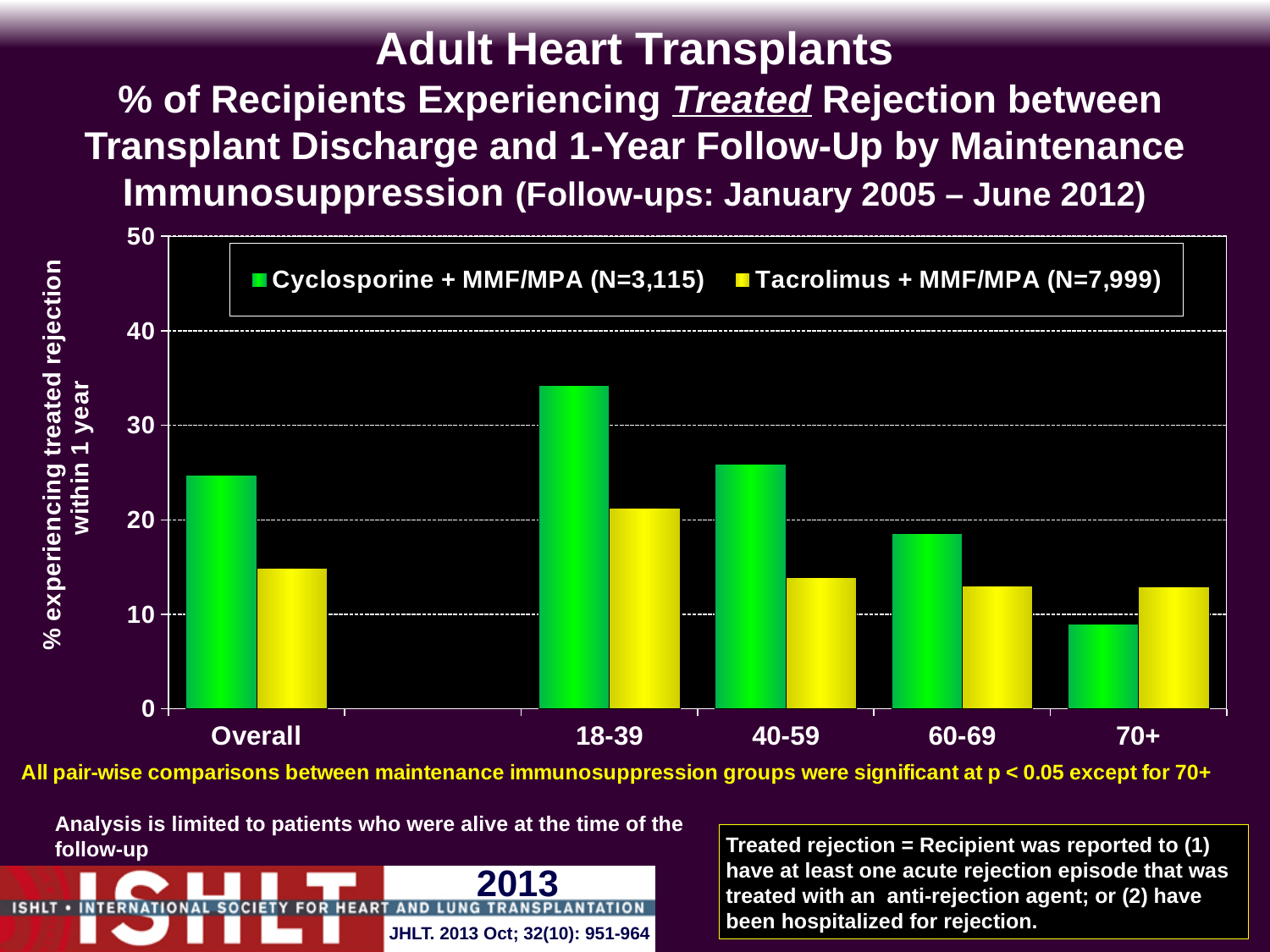
Is the value for Tacrolimus + MMF/MPA in the Overall group greater or less than 20? less Is the value for Cyclosporine + MMF/MPA in the 18-39 group greater or less than 30? greater In the 70+ group, which series has the larger value? Tacrolimus + MMF/MPA Do the Cyclosporine + MMF/MPA values rise or fall across the age groups from 18-39 to 70+? fall Which category has the highest value for Cyclosporine + MMF/MPA? 18-39 What sample size (N) does the legend give for Tacrolimus + MMF/MPA? N=7,999 How many series does the legend list? 2 Which category has the lowest value for Cyclosporine + MMF/MPA? 70+ How many categories are shown on the x axis? 5 Is the value for Cyclosporine + MMF/MPA in the 40-59 group greater or less than 20? greater What kind of chart is shown on the slide? bar chart Which category has the highest value for Tacrolimus + MMF/MPA? 18-39